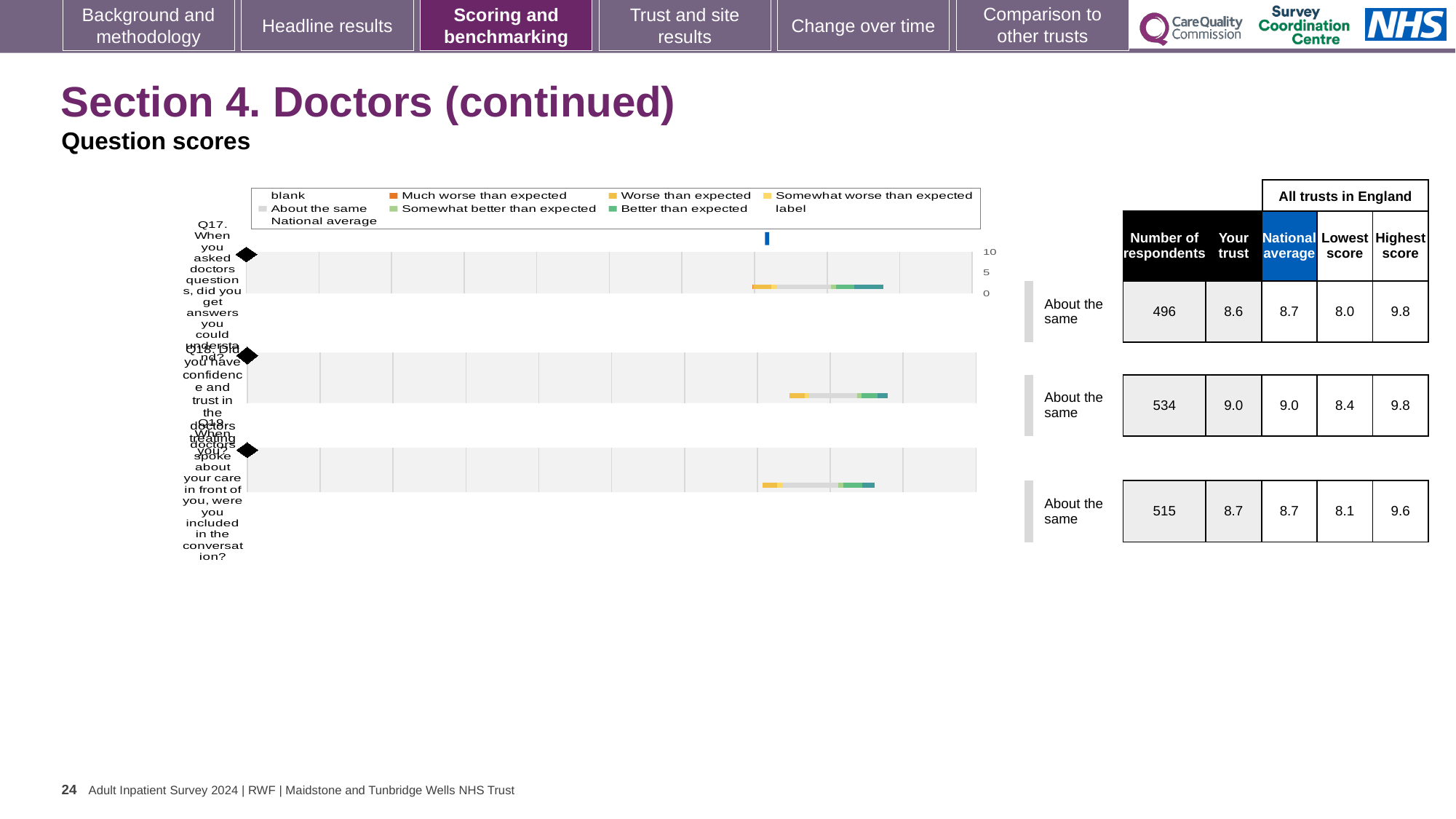
What kind of chart is used to show the question scores on this slide? bar chart For Q17, which is larger in the table beside the chart: the 'Your trust' score or the national average? National average What is the highest value shown on the chart's score axis? 10 What benchmark category is shown for Q19 next to the chart? About the same Which legend entry is shown in orange, representing the worst benchmark band? Much worse than expected How many questions (categories) are plotted in the chart? 3 In the table beside the chart, what is the difference between the highest score and the lowest score for Q18? 1.4 In the table beside the chart, what is the national average for Q19? 8.7 Which question has the largest number of respondents in the table beside the chart? Q18 In the table beside the chart, what is the lowest score across all trusts in England for Q17? 8.0 In the table beside the chart, how many respondents are listed for Q17? 496 In the table beside the chart, what is the 'Your trust' score for Q18? 9.0